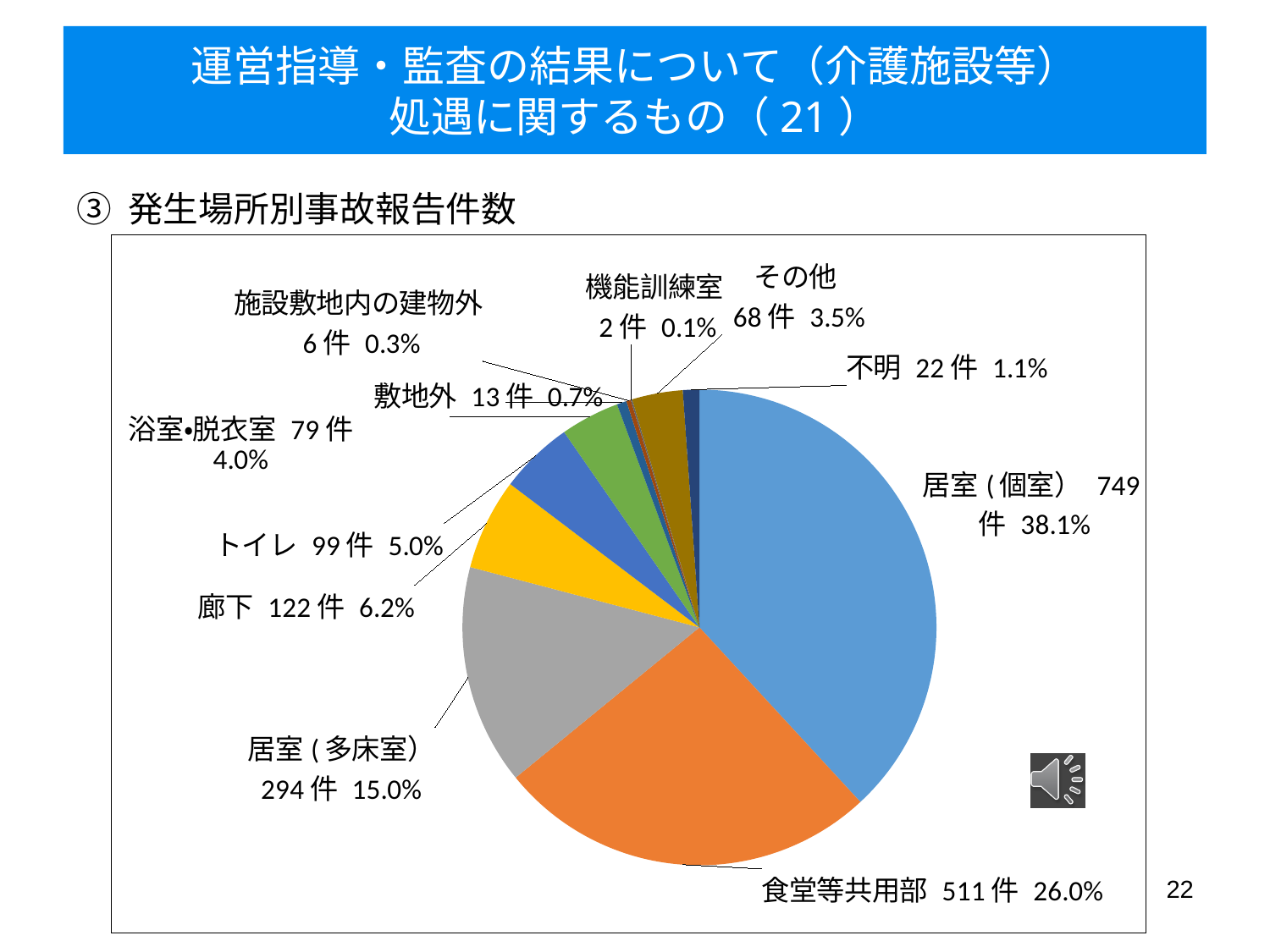
How many location categories are shown in the pie chart? 11 How many accident reports are classified as 不明? 22件 Which location has the lowest number of accident reports? 機能訓練室 Which has more accident reports, トイレ or 浴室・脱衣室? トイレ Which location has the highest number of accident reports? 居室（個室） What percentage of accident reports occurred in 廊下? 6.2% What is the title of the section above the chart? ③ 発生場所別事故報告件数 What kind of chart is shown on the slide? pie chart How many accident reports occurred in 居室（個室）? 749件 What share of the pie does 食堂等共用部 represent? 26.0% What is the difference in the number of accident reports between 居室（個室） and 食堂等共用部? 238件 How many accident reports occurred in 居室（多床室）? 294件